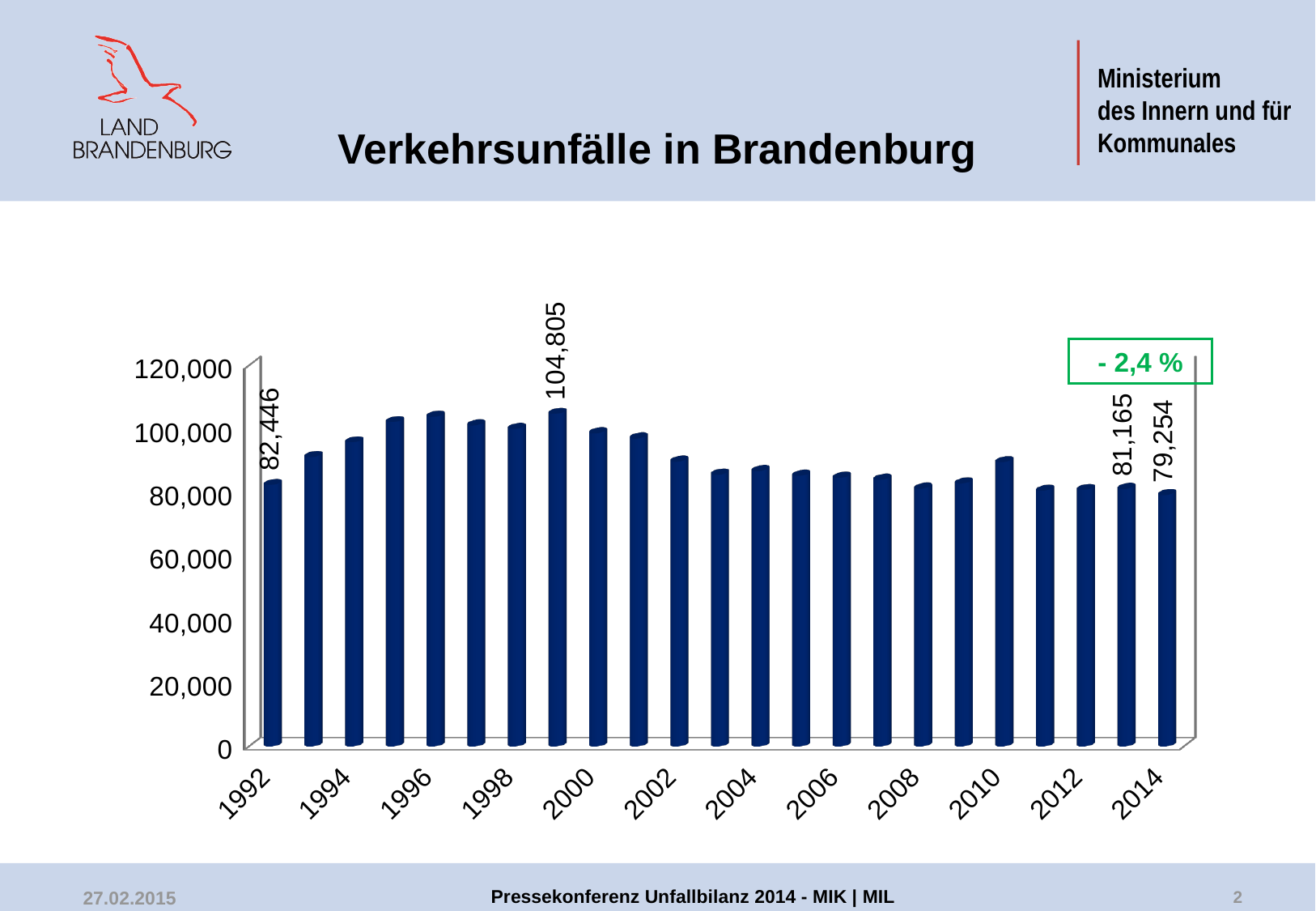
Is the value for 2005 greater or less than 100,000? less What is the difference between the values for 2013 and 2014? 1,911 How many bars are plotted in the chart? 23 What value is shown for 1999? 104,805 Which year has the lowest number of traffic accidents? 2014 What value is shown for 2014? 79,254 What value is shown for 2013? 81,165 Is the value for 2010 greater or less than 80,000? greater Which is larger, the value for 1992 or the value for 2014? 1992 What percentage change is shown in the green box on the chart? - 2,4 % What is the difference between the values for 1999 and 1992? 22,359 What value is shown for 1992? 82,446